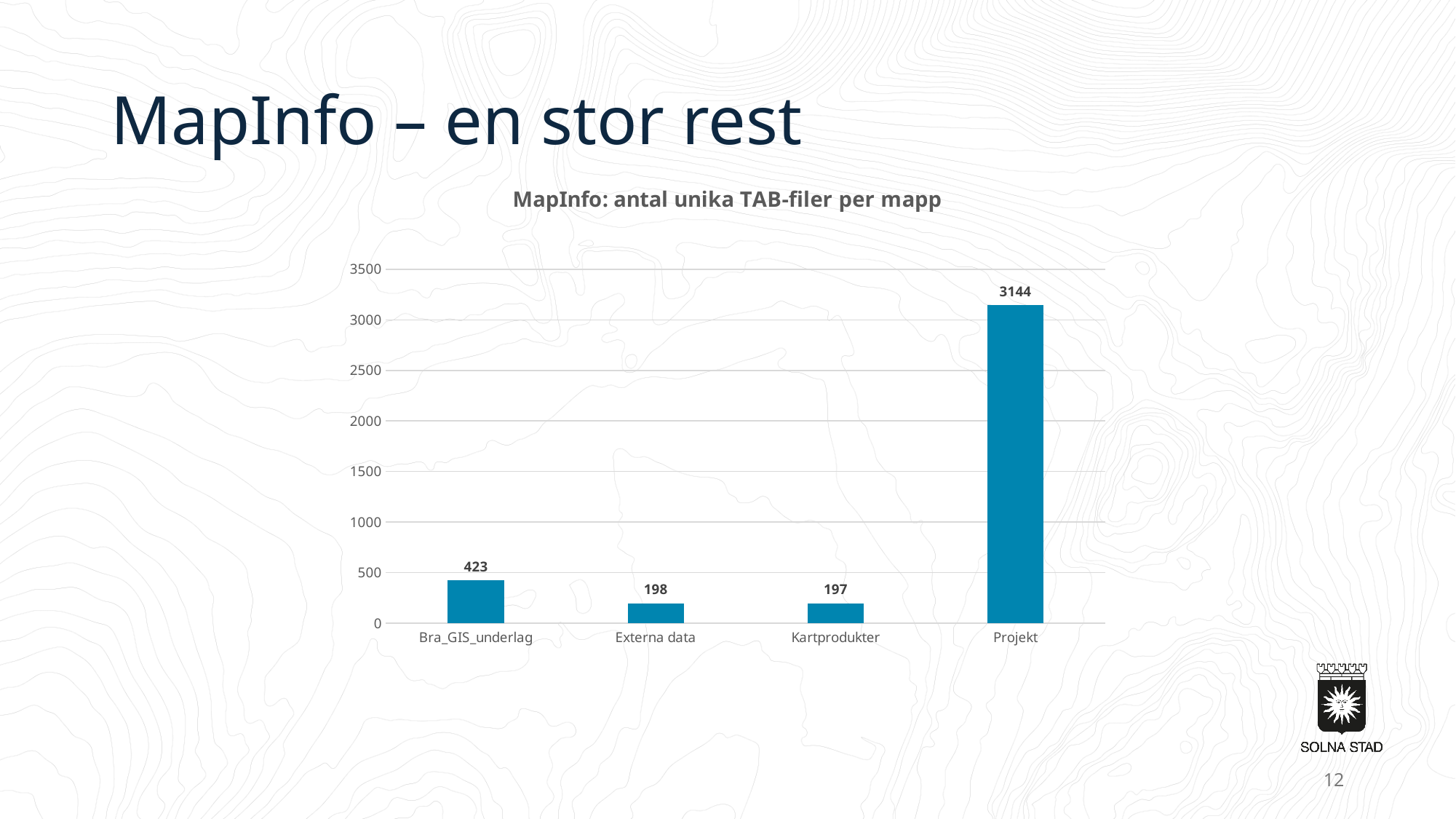
What is the title of the chart? MapInfo: antal unika TAB-filer per mapp What is the difference between the values for Bra_GIS_underlag and Externa data? 225 What is the value for Projekt? 3144 What is the value for Bra_GIS_underlag? 423 How many categories are shown on the x axis? 4 Which is larger, the value for Bra_GIS_underlag or the value for Kartprodukter? Bra_GIS_underlag Which category has the highest value? Projekt What kind of chart is shown on the slide? bar chart What is the value for Kartprodukter? 197 What is the difference between the values for Projekt and Bra_GIS_underlag? 2721 Is the value for Projekt greater or less than 3000? greater What is the value for Externa data? 198